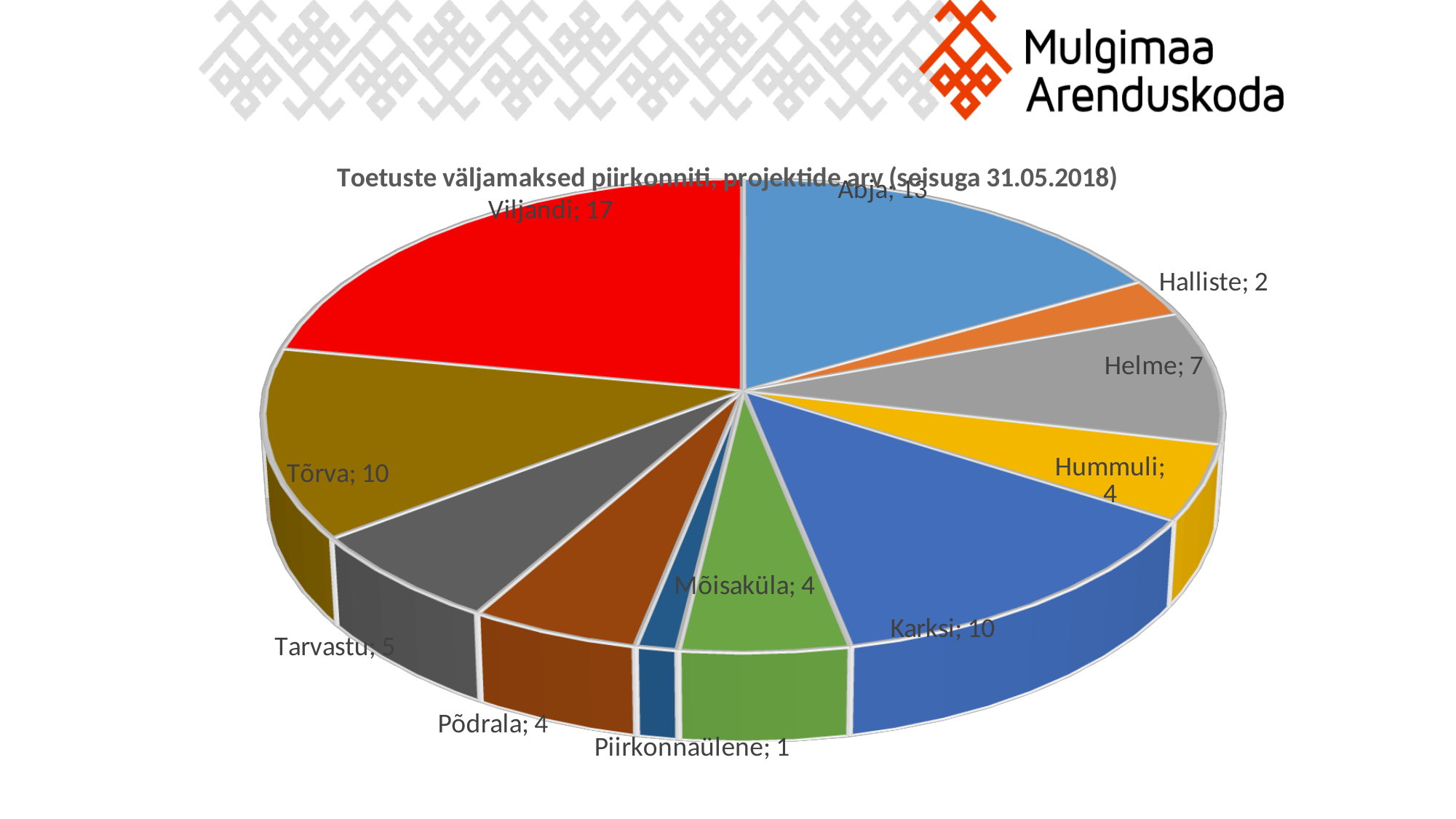
What is the title of the chart? Toetuste väljamaksed piirkonniti, projektide arv (seisuga 31.05.2018) Which region has the highest number of projects? Viljandi What is the value shown for Piirkonnaülene? 1 How many projects does the Viljandi slice represent? 17 What colour is the Viljandi slice? Red What type of chart is shown on the slide? Pie chart What is the difference between the values for Viljandi and Karksi? 7 How many slices does the pie chart have? 11 Which slice has the lowest value? Piirkonnaülene Which has a larger value, Tarvastu or Helme? Helme What is the value shown for Helme? 7 What is the difference between the values for Abja and Halliste? 11